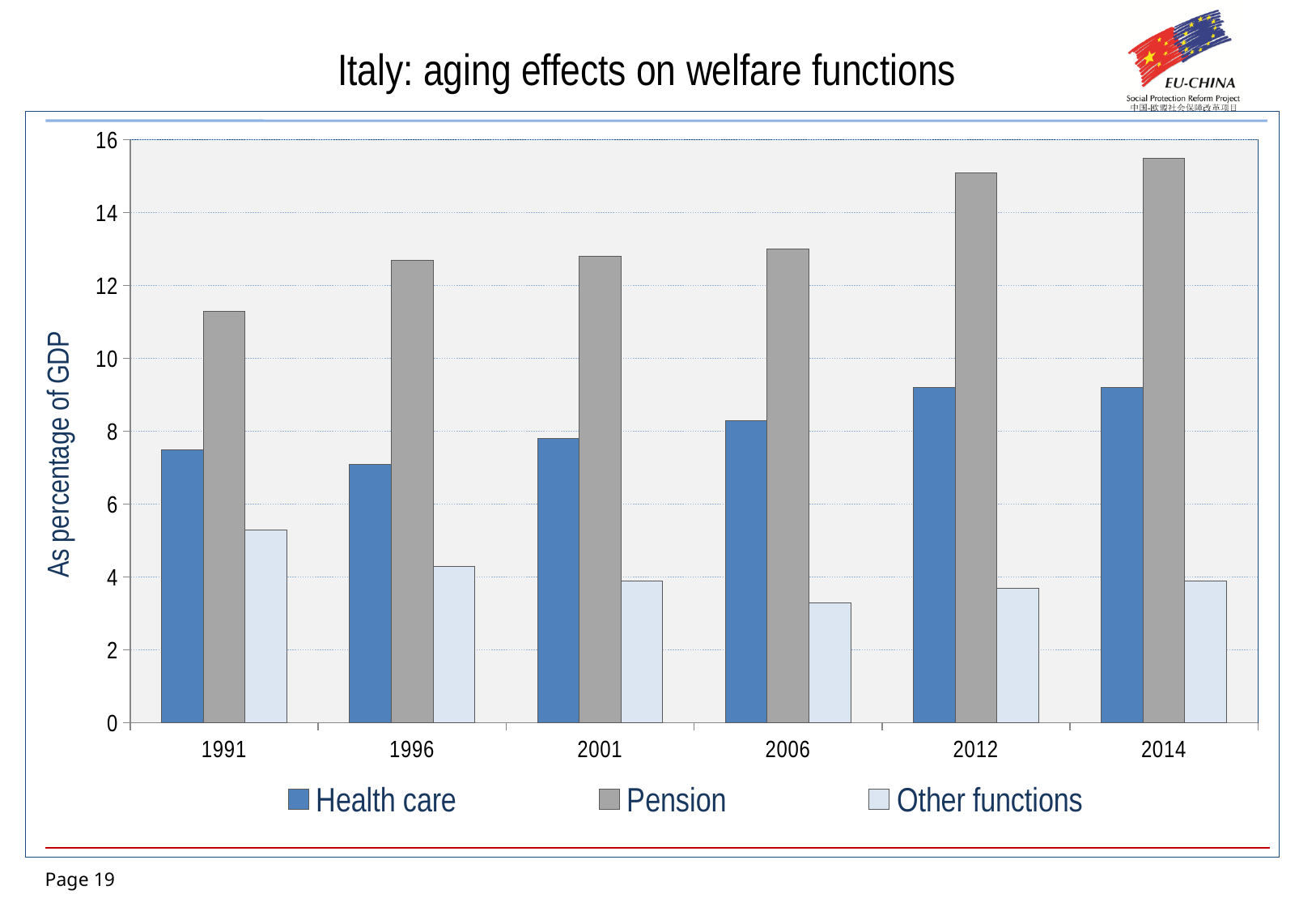
In which year is the Pension value highest? 2014 In which year is the Other functions value lowest? 2006 What kind of chart is shown on the slide? bar chart Which is larger: the Pension value for 2012 or the Pension value for 1991? 2012 Is the Other functions value for 1991 greater or less than 5? greater Does the Pension series rise or fall from 1991 to 2014? rise Is the Pension value for 1991 greater or less than 12? less How many series does the legend list? 3 How many years are shown on the x axis? 6 What is the label on the y axis? As percentage of GDP In which year is the Health care value lowest? 1996 Is the Health care value for 2006 greater or less than 8? greater